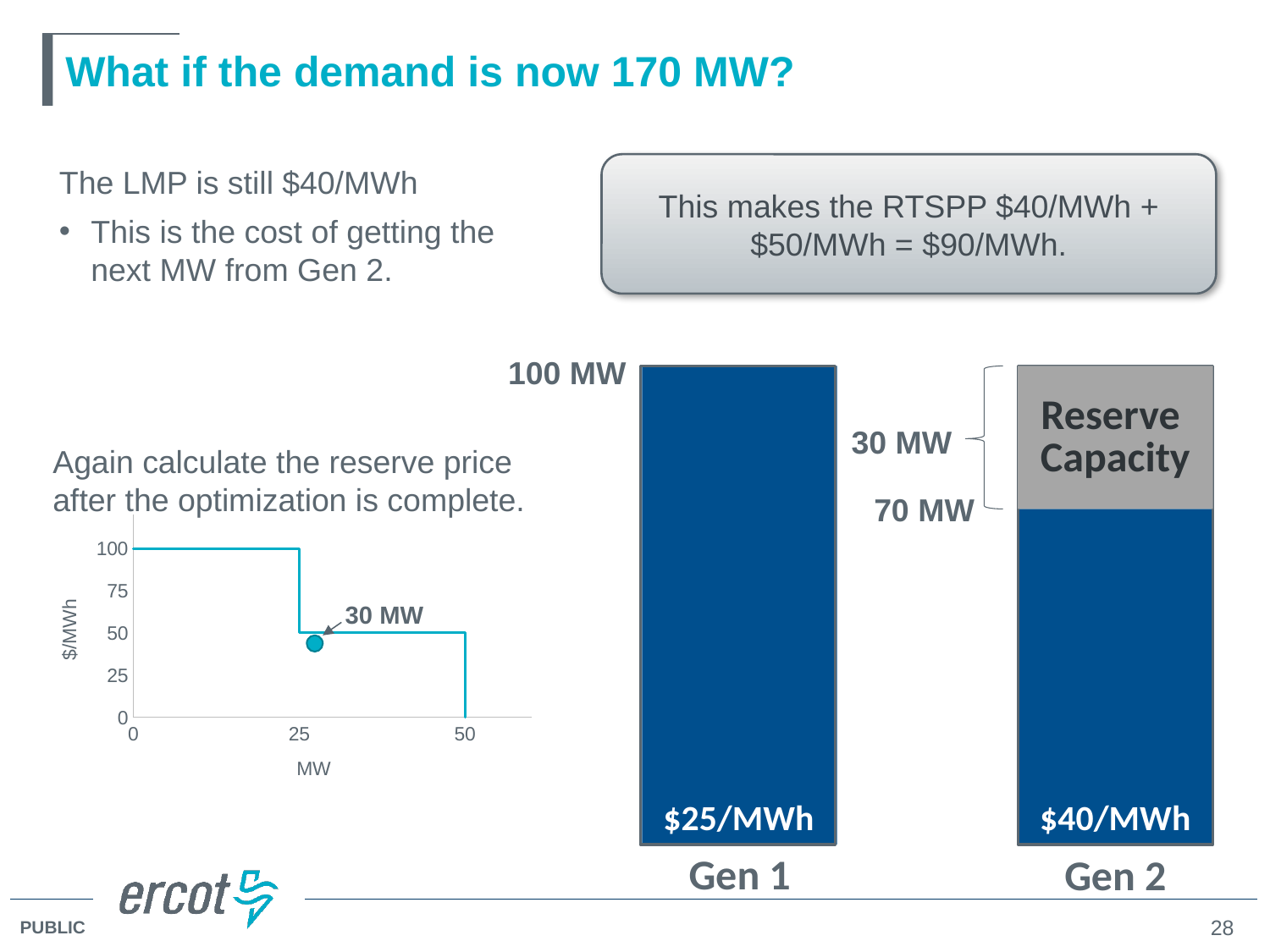
In the bar chart on the right, how many MW does the blue (non-reserve) portion of the Gen 2 bar represent? 70 MW In the bar chart on the right, which generator has the higher price per MWh, Gen 1 or Gen 2? Gen 2 In the bar chart on the right, what is the total capacity of the Gen 2 bar (blue portion plus Reserve Capacity)? 100 MW In the bar chart on the right, what price is labelled on the Gen 2 bar? $40/MWh In the step chart on the left, what is the $/MWh value of the line between 25 MW and 50 MW? 50 In the step chart on the left, what is the label on the y axis? $/MWh In the bar chart on the right, what price is labelled on the Gen 1 bar? $25/MWh What kind of chart is the chart on the right showing Gen 1 and Gen 2? bar chart In the bar chart on the right, how many MW of Gen 2 are marked as Reserve Capacity? 30 MW How many generators are shown in the bar chart on the right? 2 In the step chart on the left, does the $/MWh value rise or fall as MW increases? fall In the bar chart on the right, what is the difference between the Gen 2 price and the Gen 1 price? $15/MWh